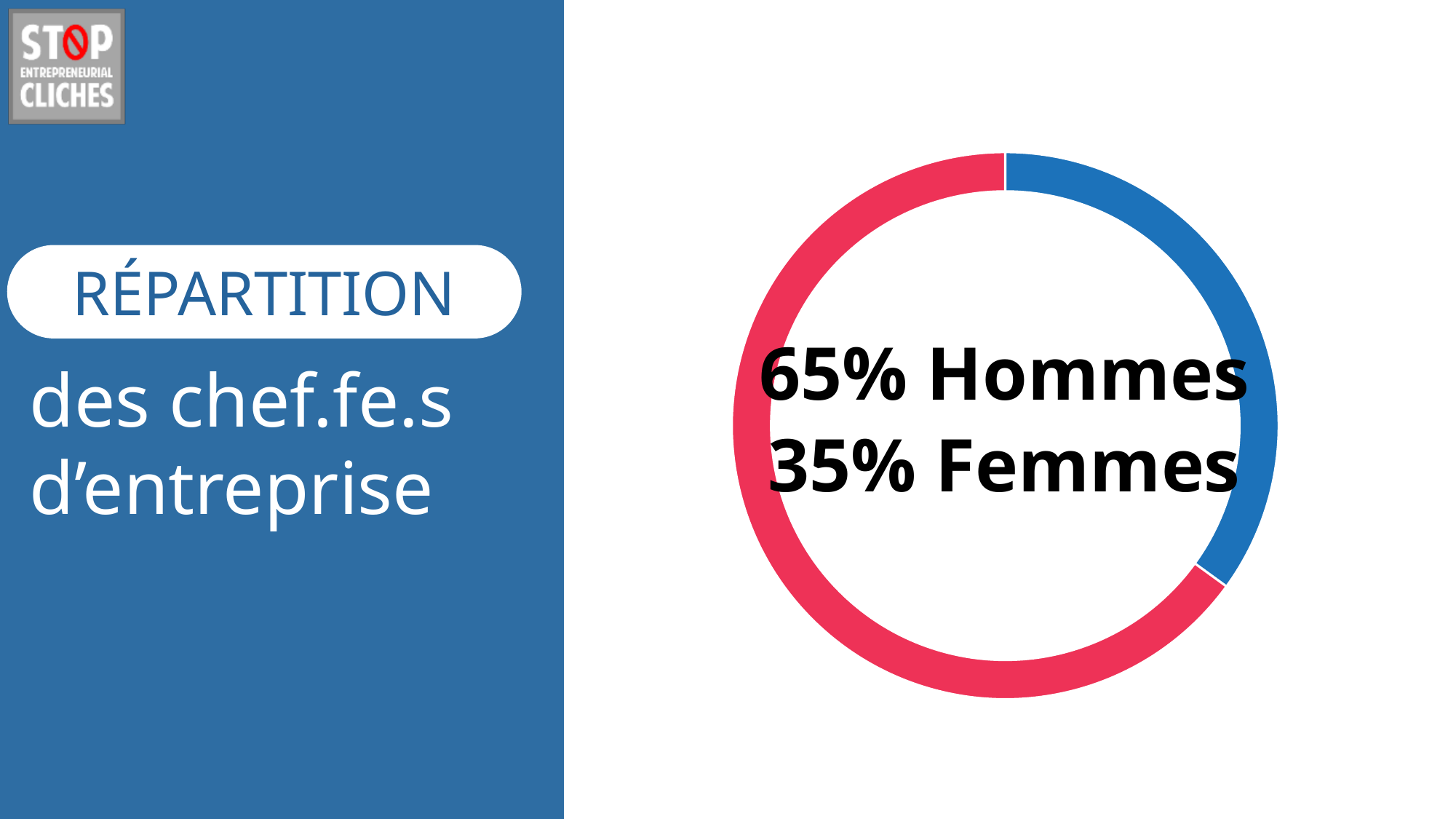
Which colour is used for the larger segment of the donut chart? Red Which category has the smaller share in the chart? Femmes How many categories does the chart divide the chef.fe.s d'entreprise into? 2 Is the share of Femmes larger or smaller than the share of Hommes? smaller Is the share of Hommes greater or less than 50%? greater What kind of chart is shown on the slide? Donut (pie) chart What share of chef.fe.s d'entreprise are Femmes according to the chart? 35% What is the title of the slide containing the chart? Répartition des chef.fe.s d'entreprise Which category has the larger share in the chart? Hommes What share of chef.fe.s d'entreprise are Hommes according to the chart? 65% What do the two shares shown in the chart add up to? 100% By how many percentage points does the Hommes share exceed the Femmes share? 30 percentage points